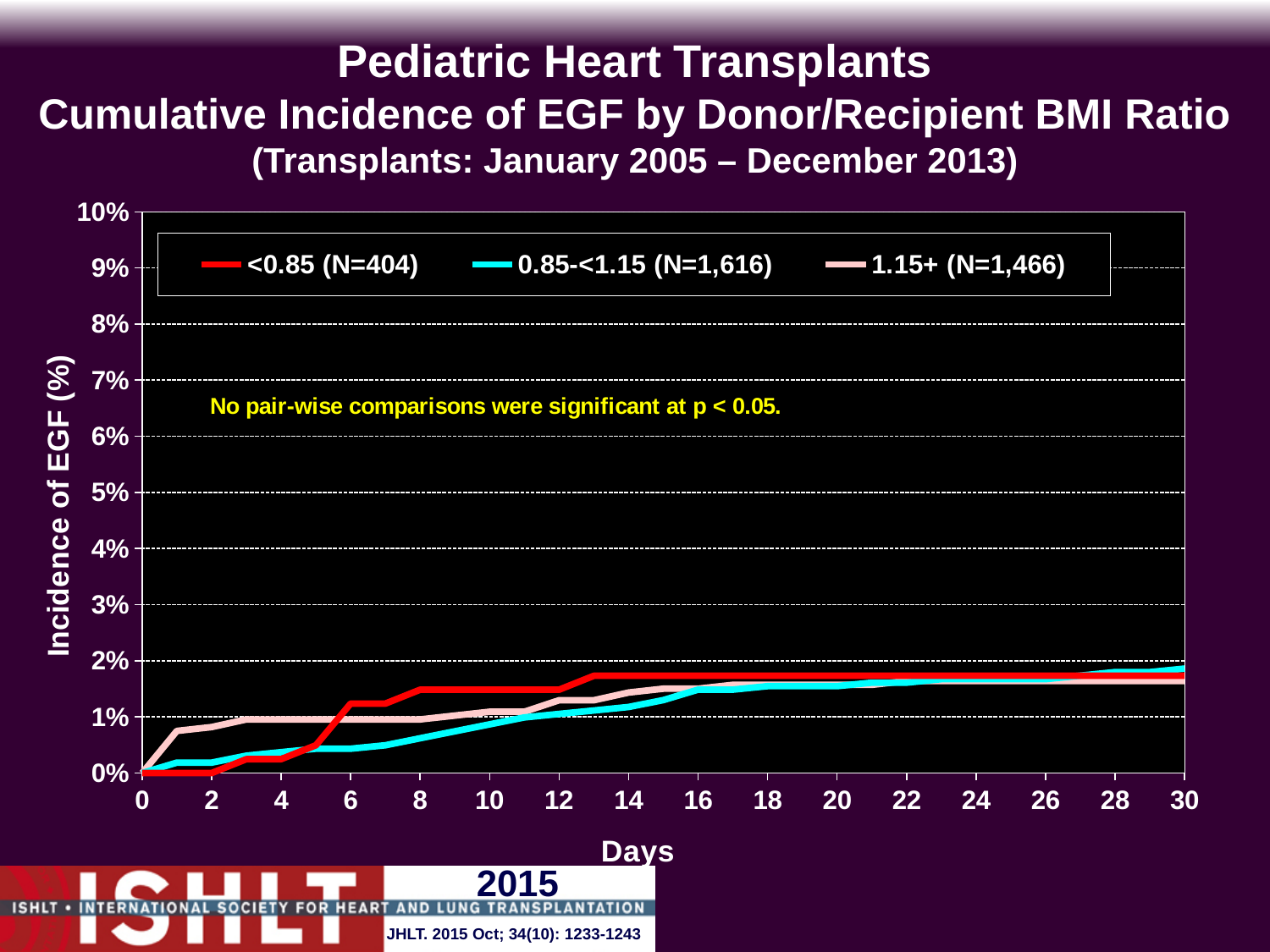
At day 8, which group has the higher cumulative incidence of EGF, <0.85 or 0.85-<1.15? <0.85 Which group has the largest N according to the legend? 0.85-<1.15 (N=1,616) What is the N for the <0.85 donor/recipient BMI ratio group shown in the legend? N=404 At day 2, is the value for the 1.15+ group greater or less than 1%? less At day 8, is the value for the 0.85-<1.15 group greater or less than 1%? less At day 8, is the value for the <0.85 group greater or less than 1%? greater At day 30, which group has the highest cumulative incidence of EGF? 0.85-<1.15 At day 2, which group has the higher cumulative incidence of EGF, 1.15+ or <0.85? 1.15+ Does the cumulative incidence of EGF for the 0.85-<1.15 group rise or fall as days increase? rise How many series does the legend list? 3 What kind of chart is shown on the slide? line chart